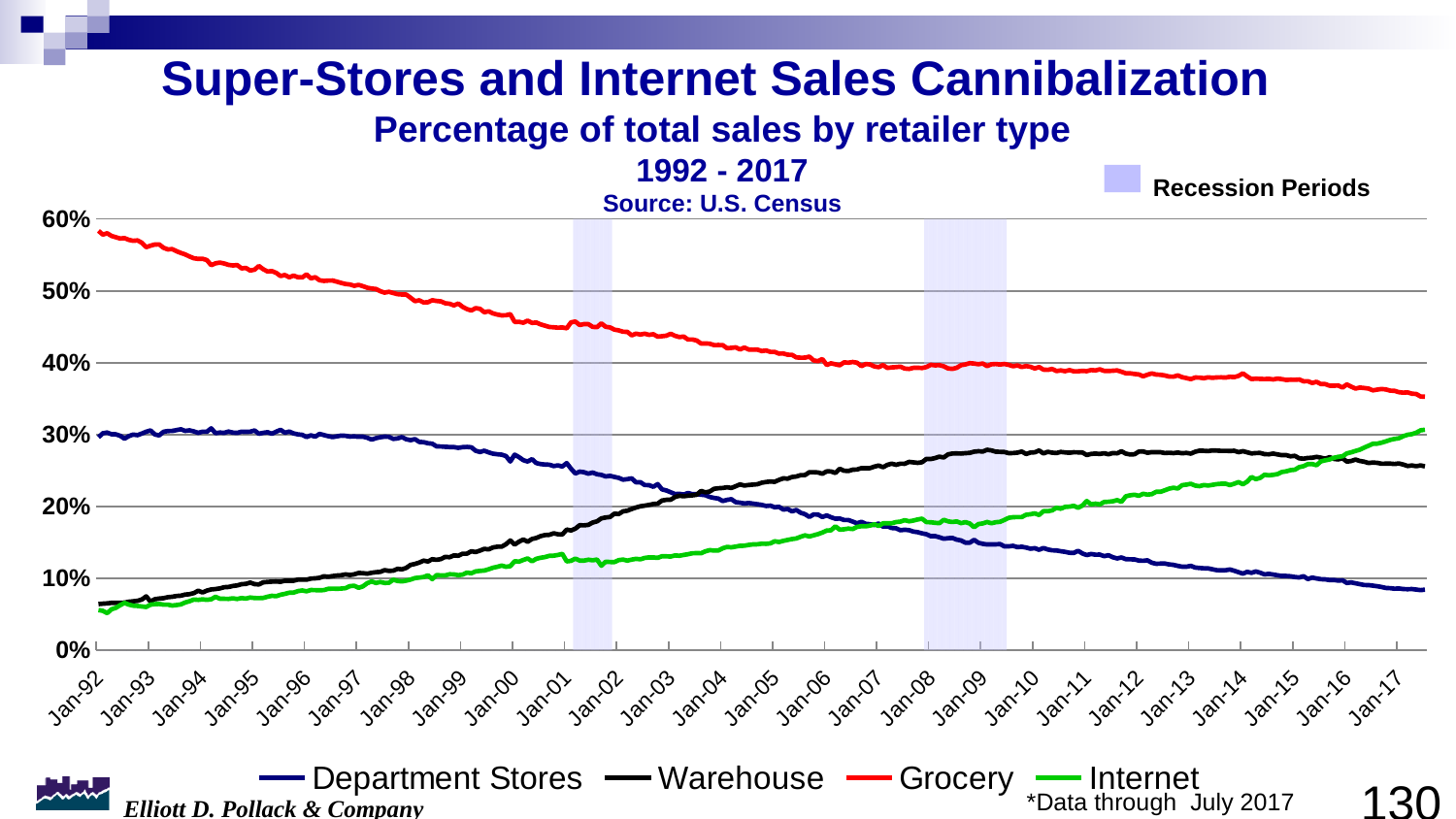
Which retailer type has the highest share at Jan-92? Grocery What kind of chart is shown on the slide? line chart At Jan-17, which is larger: Internet or Warehouse? Internet Is the value for Grocery at Jan-92 greater or less than 50%? greater What do the shaded vertical bands on the chart represent? Recession Periods Is the value for Warehouse at Jan-17 greater or less than 20%? greater Which retailer type has the lowest share at Jan-17? Department Stores Does the Internet line rise or fall from Jan-92 to Jan-17? rise Is the value for Internet at Jan-92 greater or less than 10%? less How many series does the legend list? 4 Does the Department Stores line rise or fall over the period shown? fall Does the Grocery line rise or fall from Jan-92 to Jan-17? fall